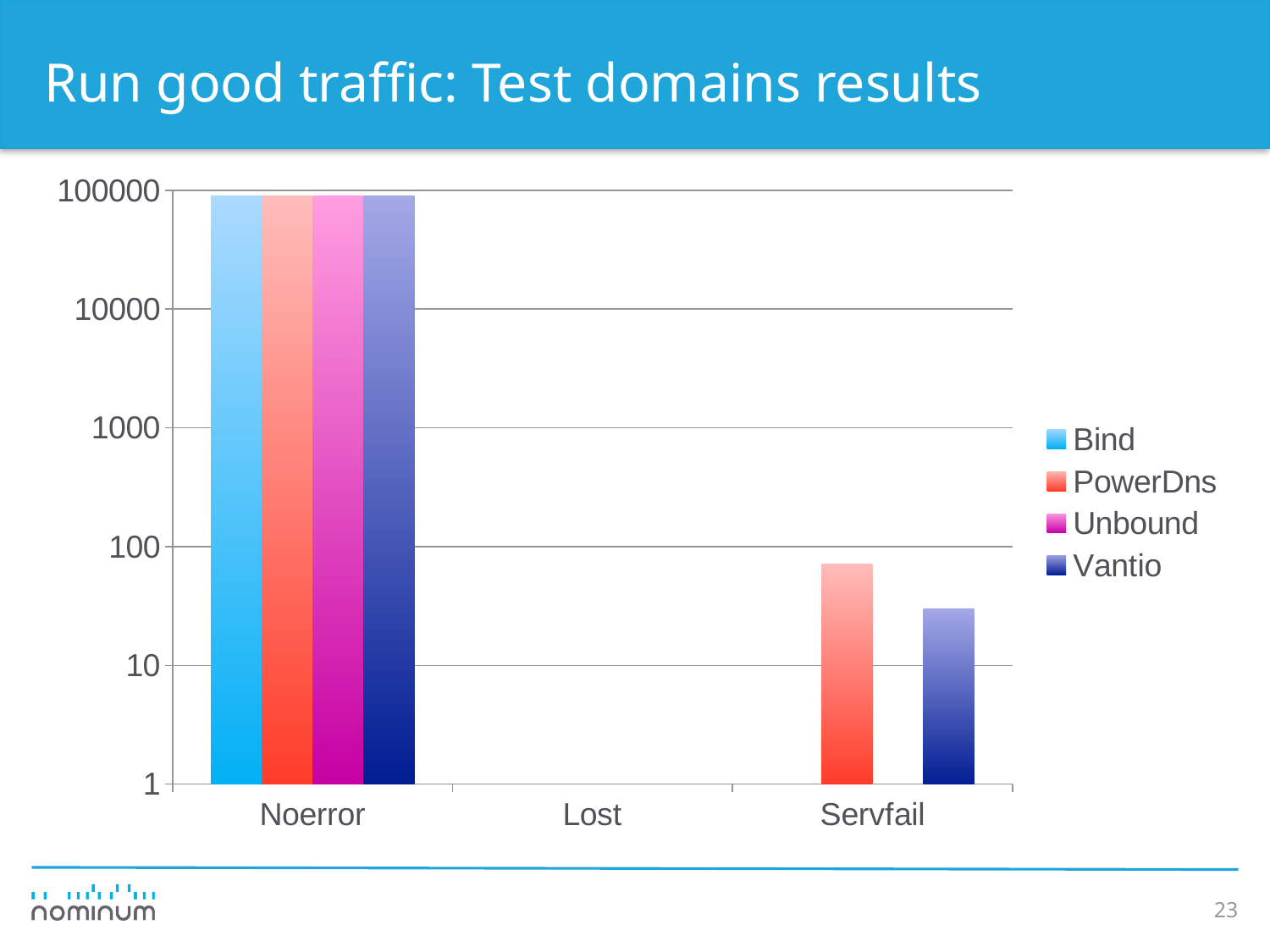
Which series are listed in the legend? Bind, PowerDns, Unbound, Vantio Is the value for Bind in the Noerror category greater or less than 10000? greater What is the title of the slide containing the chart? Run good traffic: Test domains results Which series has the highest value in the Servfail category? PowerDns Is the value for Vantio in the Servfail category greater or less than 10? greater What kind of chart is shown on the slide? bar chart How many series does the legend list? 4 Is the value for PowerDns in the Servfail category greater or less than 100? less Which category has no visible bars for any series? Lost In the Servfail category, which is larger: PowerDns or Vantio? PowerDns How many categories are shown on the x axis? 3